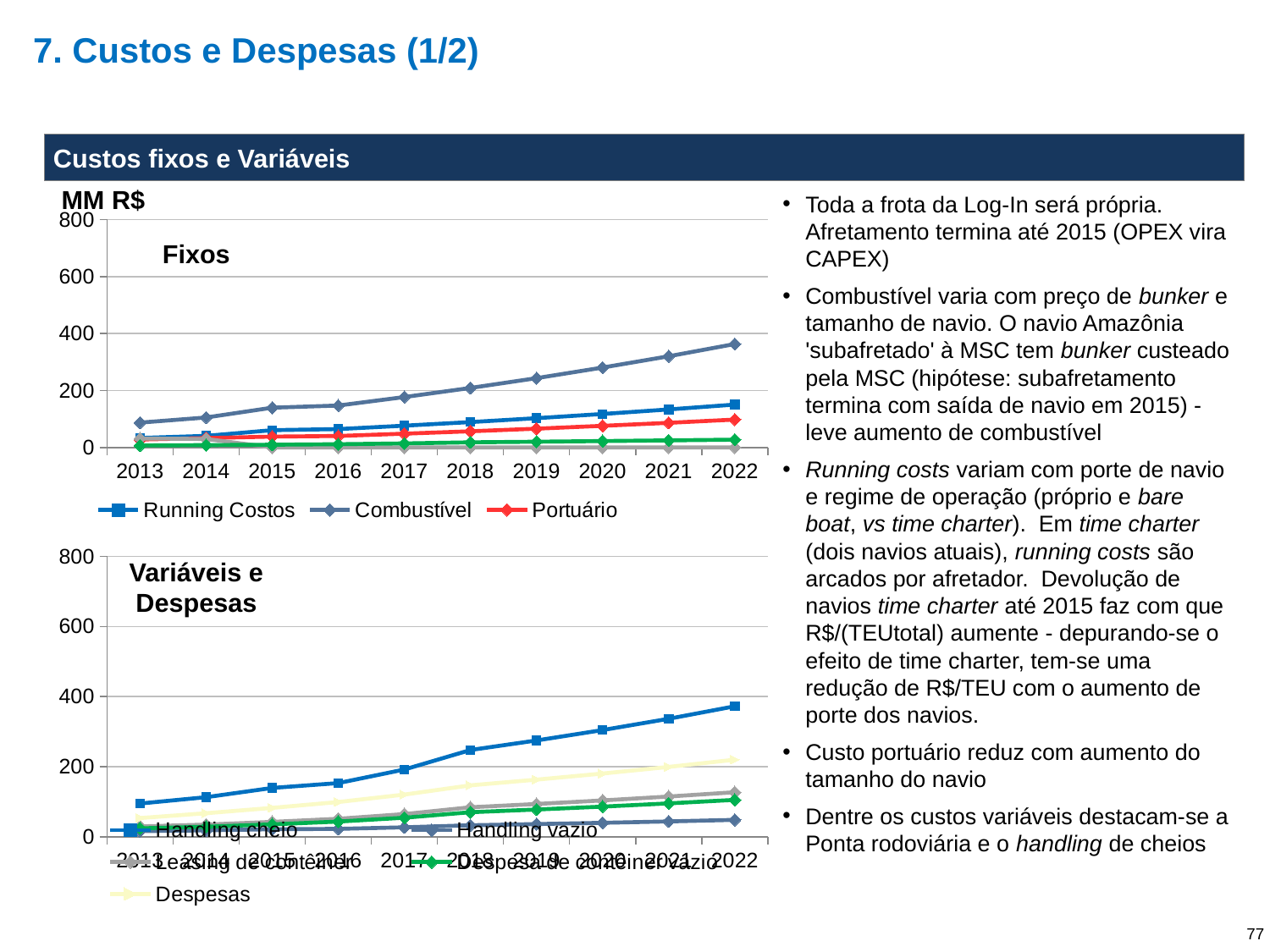
In the "Fixos" chart, which series has the highest value in 2022? Combustível What kind of chart is the top chart titled "Fixos"? line chart What unit is shown above the charts? MM R$ In the "Variáveis e Despesas" chart, which series has the highest value in 2022? Handling cheio In the "Fixos" chart, does the Combustível series rise or fall from 2013 to 2022? rise In the "Variáveis e Despesas" chart, is the value for Handling vazio in 2022 greater or less than 200? less How many series does the legend of the "Variáveis e Despesas" chart list? 5 In the "Variáveis e Despesas" chart, is the value for Handling cheio in 2022 greater or less than 400? less In the "Fixos" chart, is the value for Combustível in 2022 greater or less than 200? greater How many years are shown on the x axis of the "Fixos" chart? 10 In the "Variáveis e Despesas" chart, which is larger in 2022: Handling cheio or Handling vazio? Handling cheio